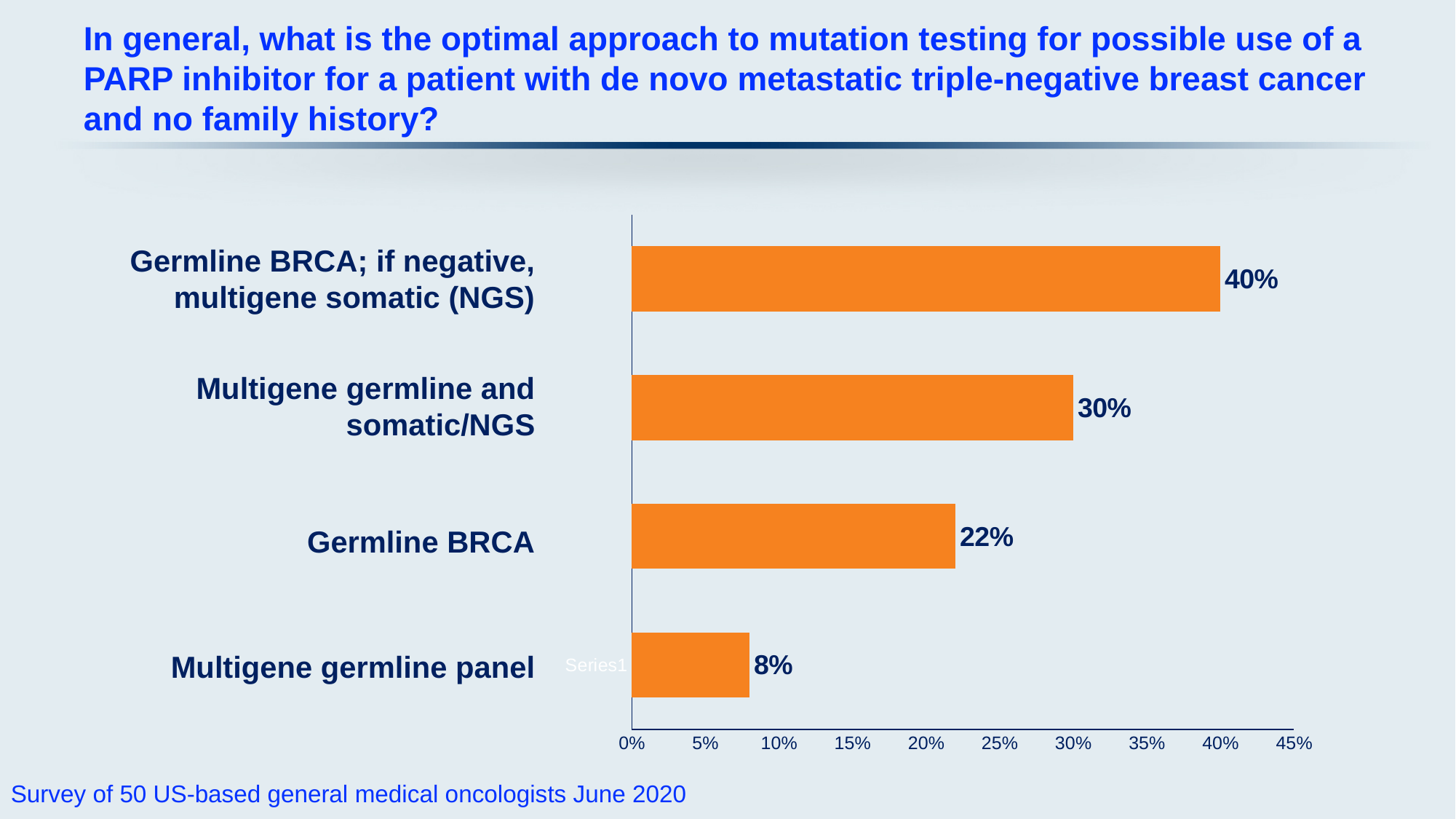
What kind of chart is shown on the slide? Bar chart What is the value for "Multigene germline and somatic/NGS"? 30% What percentage of respondents chose "Germline BRCA; if negative, multigene somatic (NGS)"? 40% How many response categories are shown in the chart? 4 What is the value for "Multigene germline panel"? 8% What is the maximum value shown on the horizontal axis? 45% What is the difference between the values for "Germline BRCA; if negative, multigene somatic (NGS)" and "Multigene germline and somatic/NGS"? 10% Which approach received the highest percentage? Germline BRCA; if negative, multigene somatic (NGS) What is the difference between the values for "Germline BRCA" and "Multigene germline panel"? 14% Which approach received the lowest percentage? Multigene germline panel What is the value for "Germline BRCA"? 22% Which is larger: the value for "Germline BRCA" or the value for "Multigene germline and somatic/NGS"? Multigene germline and somatic/NGS